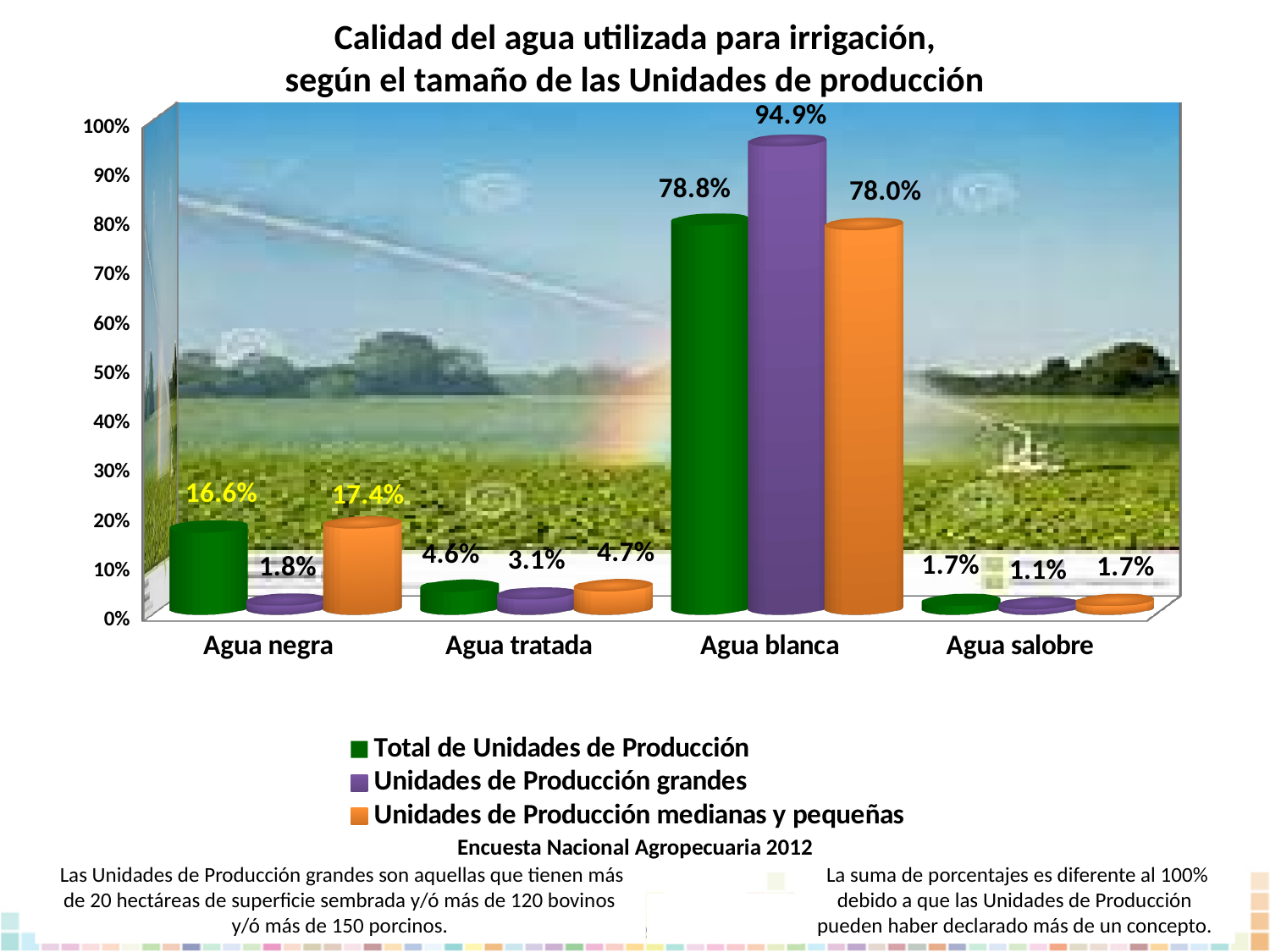
What is the value for Total de Unidades de Producción in the Agua negra category? 16.6% What is the value for Unidades de Producción medianas y pequeñas in the Agua tratada category? 4.7% What is the value for Unidades de Producción grandes in the Agua salobre category? 1.1% How many series does the legend list? 3 In the Agua negra category, which is larger: the value for Unidades de Producción grandes or for Unidades de Producción medianas y pequeñas? Unidades de Producción medianas y pequeñas What kind of chart is shown on the slide? Bar chart How many categories are shown on the x axis? 4 What is the value for Unidades de Producción grandes in the Agua blanca category? 94.9% Which series is shown in purple in the legend? Unidades de Producción grandes What is the difference between the Unidades de Producción grandes value and the Total de Unidades de Producción value in the Agua blanca category? 16.1% Which category has the highest value for Total de Unidades de Producción? Agua blanca Which category has the lowest value for Unidades de Producción grandes? Agua salobre